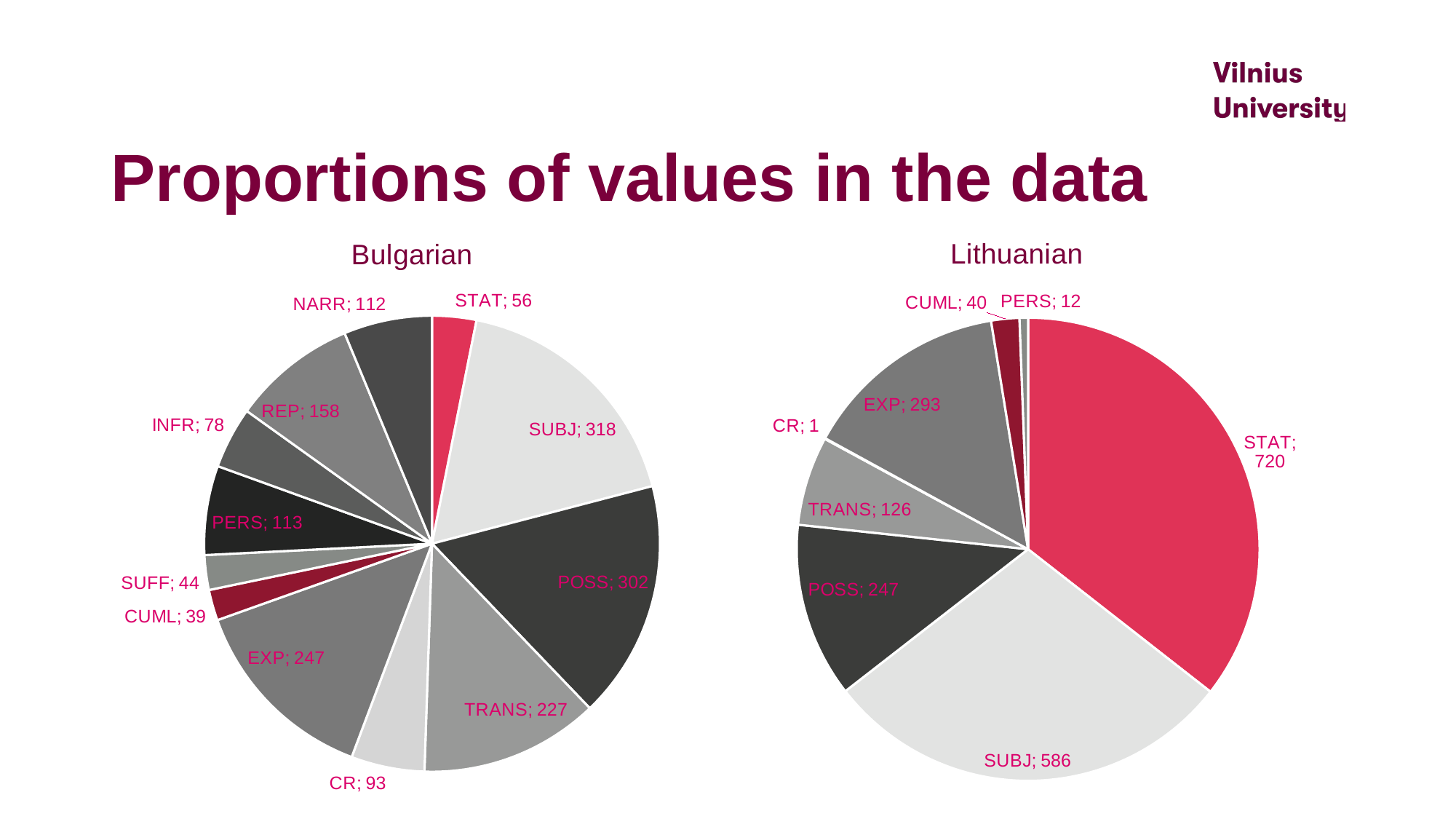
In the Bulgarian chart, what is the difference between the values for SUBJ and POSS? 16 In the Bulgarian chart, which category has the smallest value? CUML What kind of chart is used for the Lithuanian data? Pie chart How many slices does the Bulgarian pie chart have? 12 In the Lithuanian chart, which is larger, EXP or POSS? EXP In the Lithuanian chart, what is the difference between the values for STAT and SUBJ? 134 In the Bulgarian chart, which category has the largest slice? SUBJ How many slices does the Lithuanian pie chart have? 8 In the Bulgarian chart, what is the value for REP? 158 In the Lithuanian chart, what is the value for TRANS? 126 In the Bulgarian chart, what is the value for SUBJ? 318 In the Lithuanian chart, which category has the smallest slice? CR